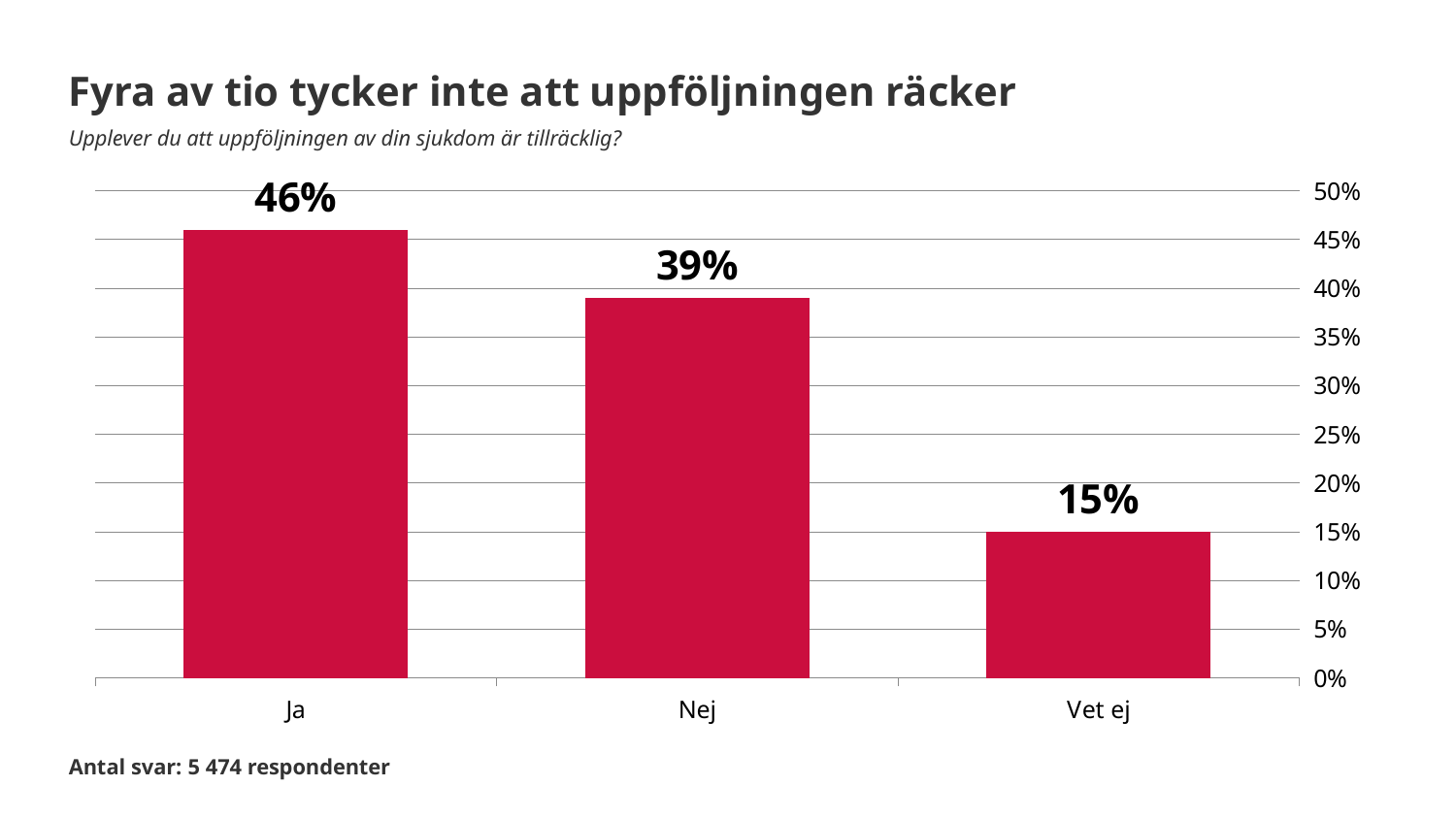
Which category has the lowest value? Vet ej What is the value for "Nej"? 39% What is the title of the slide above the chart? Fyra av tio tycker inte att uppföljningen räcker What is the difference between the values for "Ja" and "Nej"? 7% How many categories are shown on the x axis? 3 Which category has the highest value? Ja What is the value for "Vet ej"? 15% Is the value for "Nej" greater or less than 35%? greater What is the value for "Ja"? 46% Which is larger, the value for "Nej" or the value for "Vet ej"? Nej What is the difference between the values for "Nej" and "Vet ej"? 24% What kind of chart is shown on the slide? bar chart